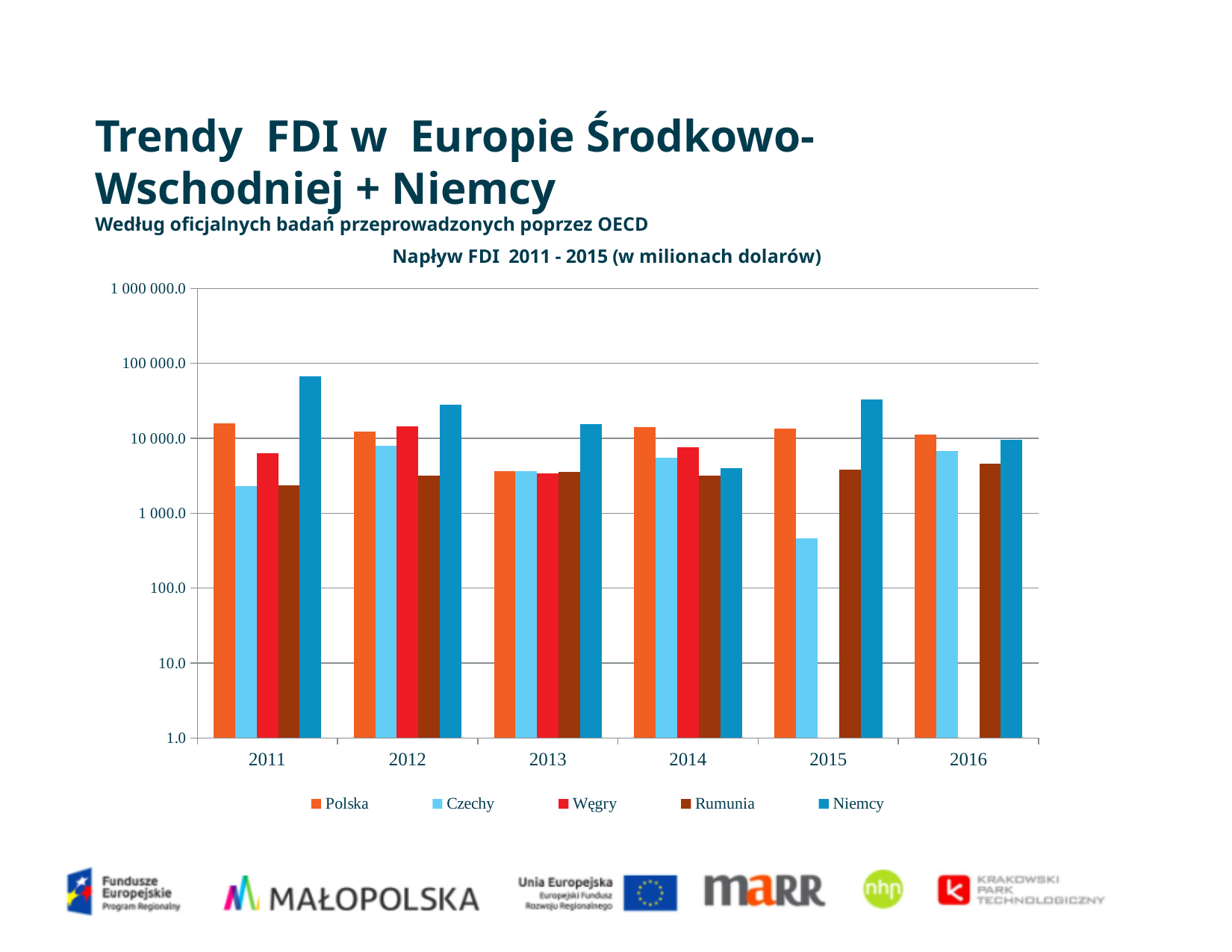
How many series does the chart legend list? 5 How many years are shown on the x axis of the chart? 6 What is the title of the chart? Napływ FDI 2011 - 2015 (w milionach dolarów) Is the value for Niemcy in 2011 greater or less than 10 000.0? greater In 2014, which is larger: the value for Polska or the value for Czechy? Polska Is the value for Polska in 2011 greater or less than 10 000.0? greater What kind of chart is shown on the slide? bar chart Which country is listed last in the chart legend? Niemcy In 2012, which is larger: the value for Niemcy or the value for Polska? Niemcy Is the value for Czechy in 2015 greater or less than 1 000.0? less Which country has the lowest value in 2015? Czechy Which country has the highest value in 2011? Niemcy